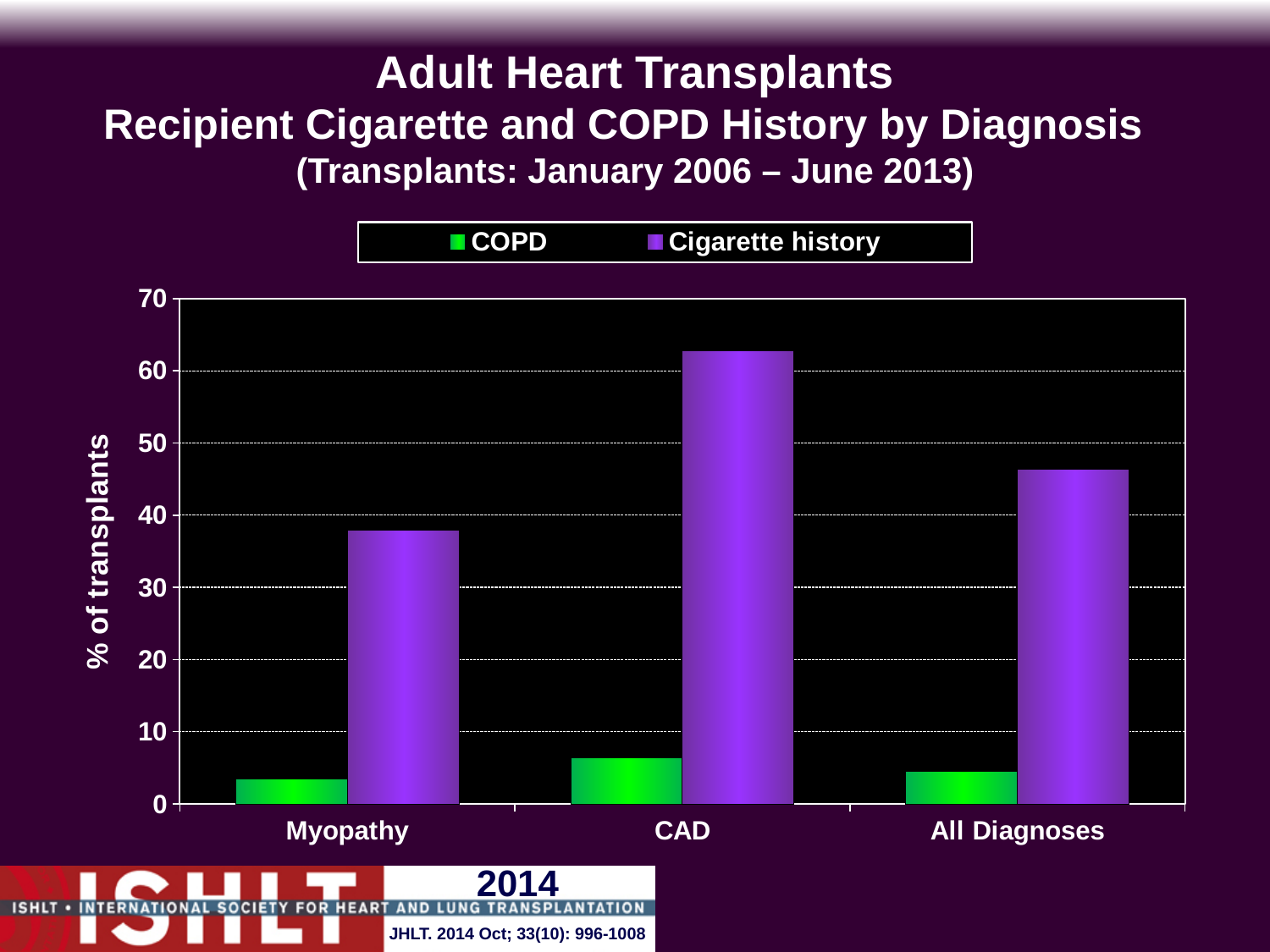
Is the Cigarette history value for All Diagnoses greater or less than 50? less Which diagnosis category has the lowest Cigarette history value? Myopathy Which diagnosis category has the highest Cigarette history value? CAD What kind of chart is shown on the slide? bar chart Is the COPD value for CAD greater or less than 10? less How many diagnosis categories are shown on the x axis? 3 What is the label on the y axis? % of transplants Is the Cigarette history value for Myopathy greater or less than 30? greater Which diagnosis category has the highest COPD value? CAD How many series does the legend list? 2 Which is larger for CAD: the COPD value or the Cigarette history value? Cigarette history